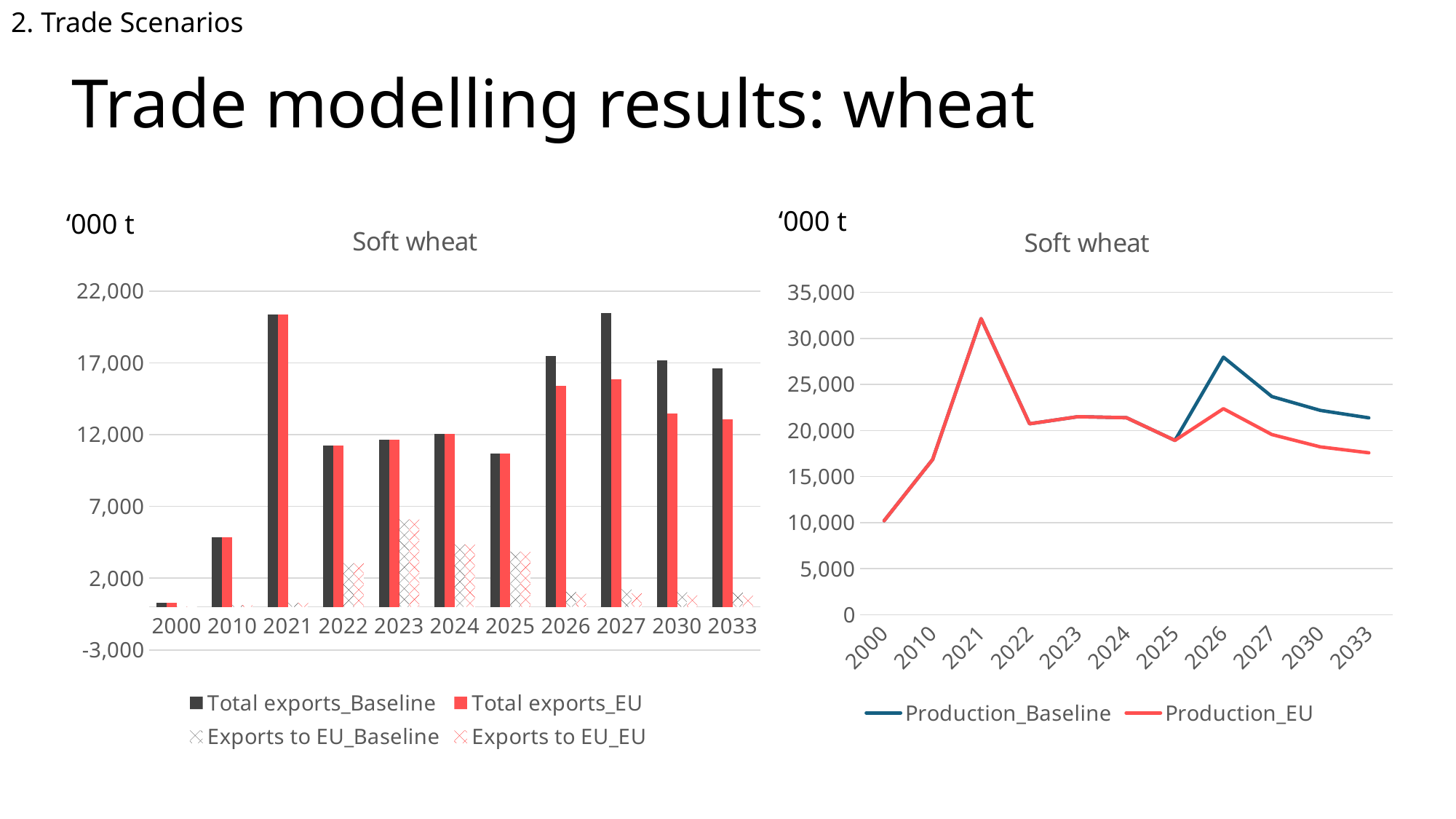
In the right-hand Soft wheat chart, is the value for Production_Baseline in 2026 greater or less than 25,000? greater How many series does the legend of the right-hand Soft wheat chart list? 2 In the left-hand Soft wheat chart, is the value for Total exports_EU in 2026 greater or less than 17,000? less What type of chart is the left-hand Soft wheat chart? bar chart How many years are shown on the x axis of the left-hand Soft wheat chart? 11 What type of chart is the right-hand Soft wheat chart? line chart In the right-hand Soft wheat chart, in which year does Production_EU reach its highest value? 2021 In the left-hand Soft wheat chart, in which year is Total exports_Baseline lowest? 2000 In the right-hand Soft wheat chart, does Production_Baseline rise or fall from 2026 to 2033? fall How many series does the legend of the left-hand Soft wheat chart list? 4 In the left-hand Soft wheat chart, in which year is Total exports_EU highest? 2021 In the left-hand Soft wheat chart, which is larger in 2027: Total exports_Baseline or Total exports_EU? Total exports_Baseline